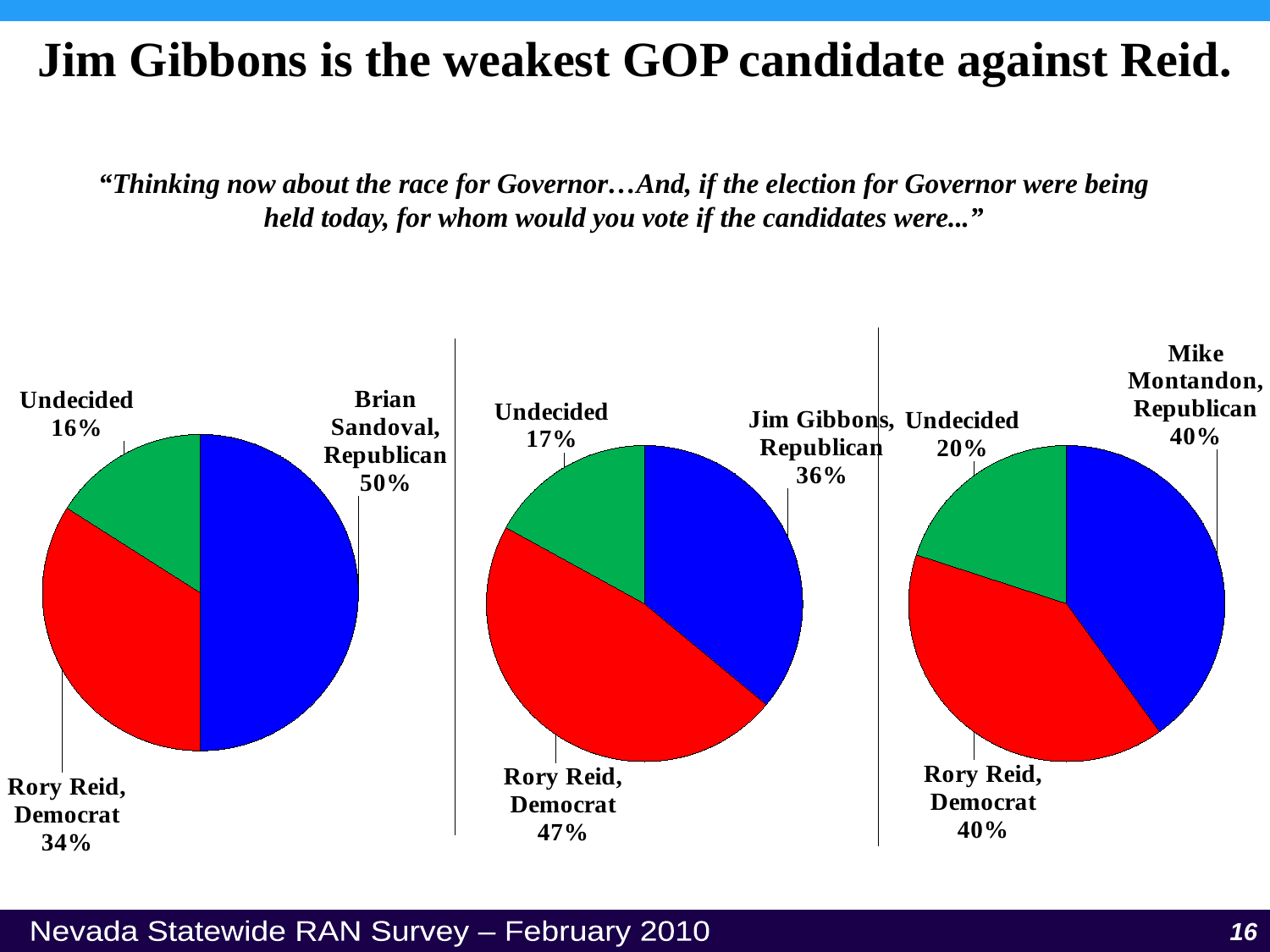
In the left pie chart, which slice is the largest? Brian Sandoval, Republican In the left pie chart, what share of the vote does Brian Sandoval, Republican receive? 50% What type of chart is used on this slide? Pie chart In the middle pie chart, what is the difference between Rory Reid's share and Jim Gibbons's share? 11% In the middle pie chart, which slice is the smallest? Undecided In the right pie chart, which is larger: Mike Montandon's share or the Undecided share? Mike Montandon, Republican In the left pie chart, what is the difference between Brian Sandoval's share and Rory Reid's share? 16% In the middle pie chart, what share of the vote does Rory Reid, Democrat receive? 47% How many pie charts are shown on the slide? 3 In the middle pie chart, what share does Jim Gibbons, Republican receive? 36% In the right pie chart, what is the Undecided share? 20% How many slices does the left pie chart have? 3